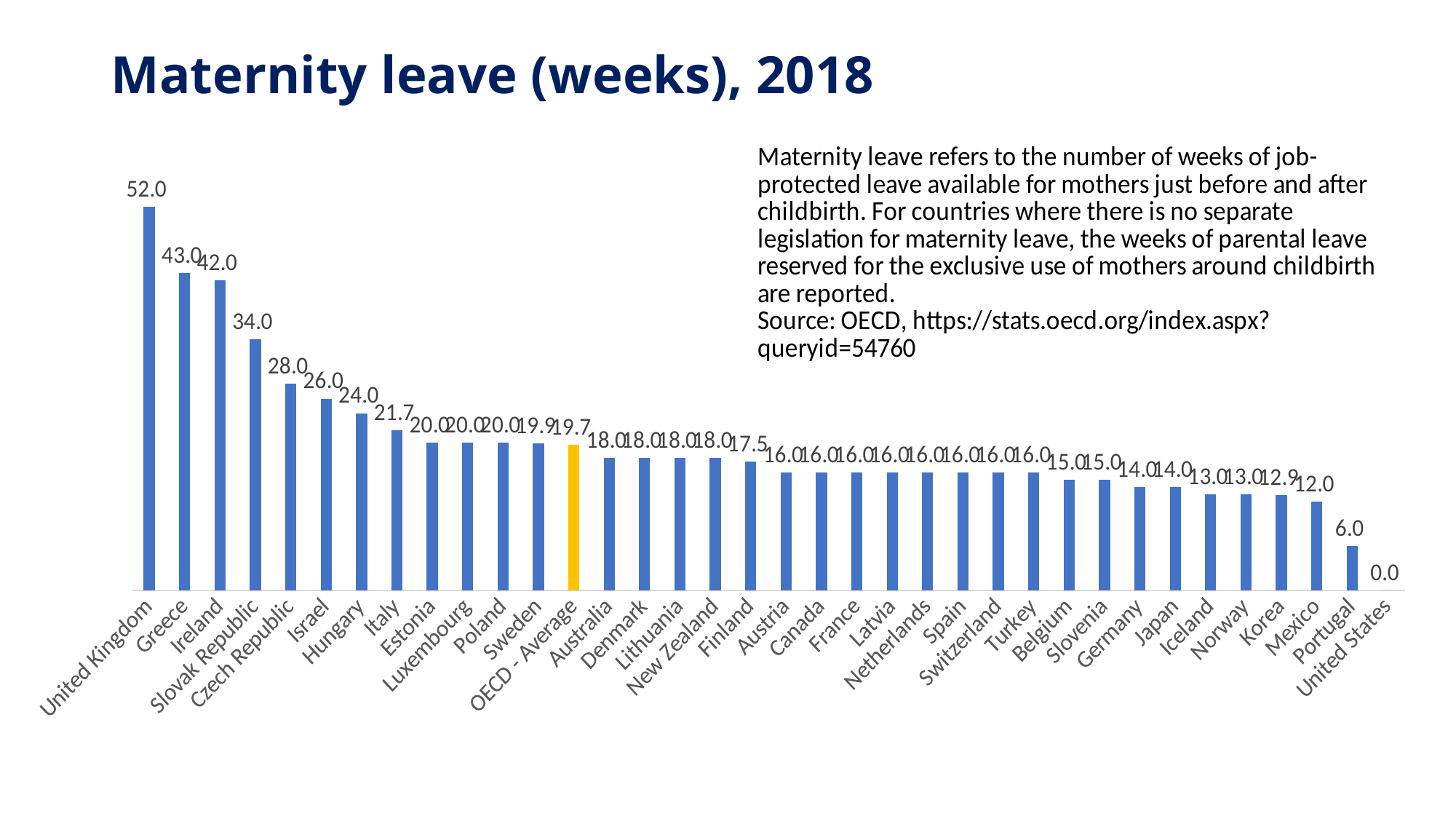
Which has a larger value, Israel or Hungary? Israel What is the difference between the values for Greece and Ireland? 1.0 Which country has the highest maternity leave value? United Kingdom Which bar is highlighted in a different colour (yellow) from the rest? OECD - Average What is the difference between the values for the United Kingdom and the Czech Republic? 24.0 What is the maternity leave value for the United Kingdom? 52.0 What is the maternity leave value for the Slovak Republic? 34.0 Which country has the lowest maternity leave value? United States What is the value shown for OECD - Average? 19.7 What is the maternity leave value for Portugal? 6.0 What type of chart is shown on the slide? Bar chart How many bars are shown in the chart? 36